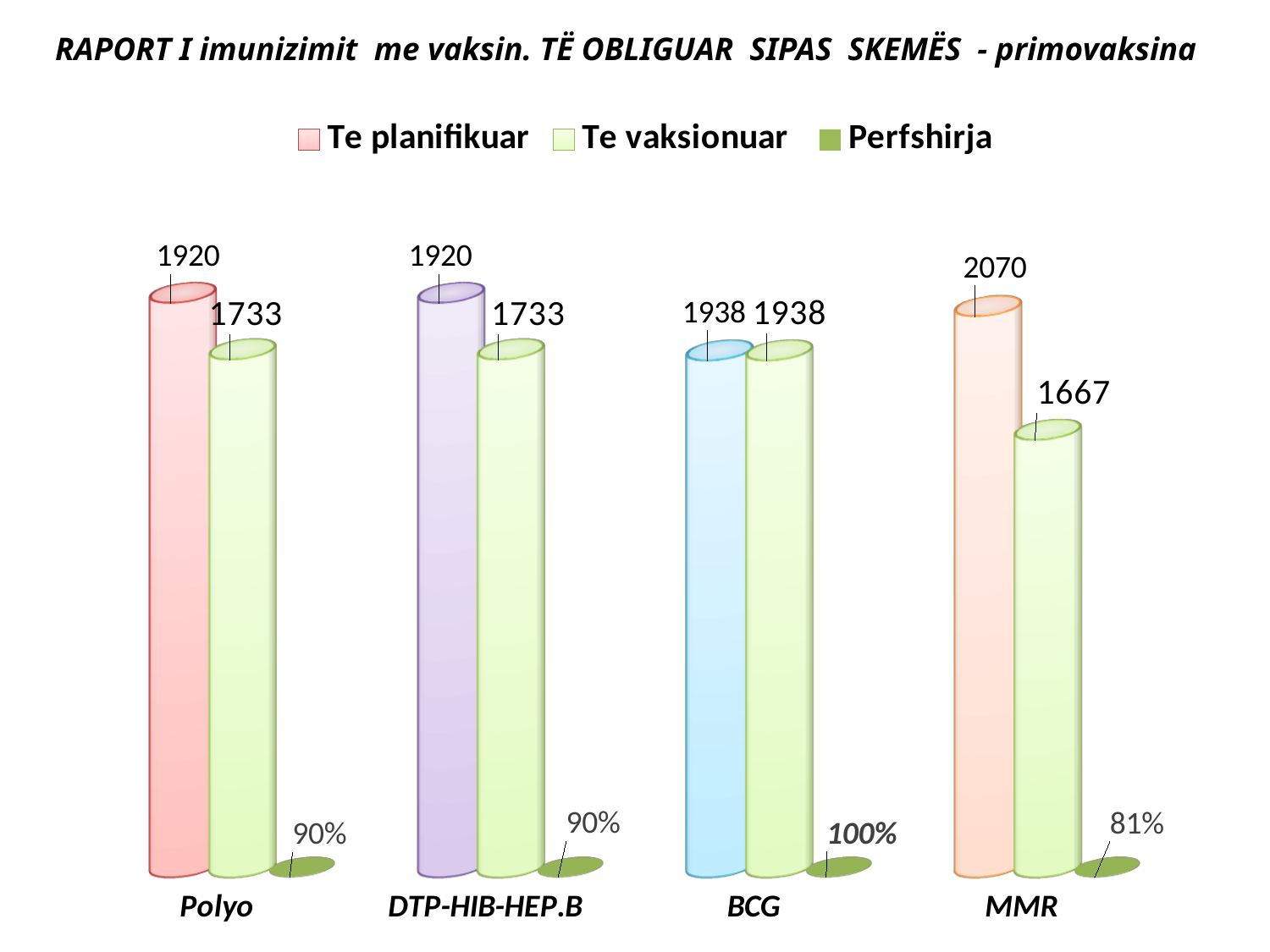
How many series does the legend list? 3 Which category has the highest 'Te planifikuar' value? MMR What is the 'Perfshirja' value for BCG? 100% What is the difference between 'Te planifikuar' and 'Te vaksionuar' for Polyo? 187 Which category has the lowest 'Perfshirja' value? MMR Which is larger: the 'Te vaksionuar' value for BCG or the 'Te vaksionuar' value for DTP-HIB-HEP.B? BCG What is the 'Te vaksionuar' value for Polyo? 1733 What is the 'Te planifikuar' value for MMR? 2070 What is the difference between 'Te planifikuar' and 'Te vaksionuar' for MMR? 403 What is the 'Te vaksionuar' value for MMR? 1667 How many categories are shown on the x axis? 4 What kind of chart is shown on the slide? Bar chart